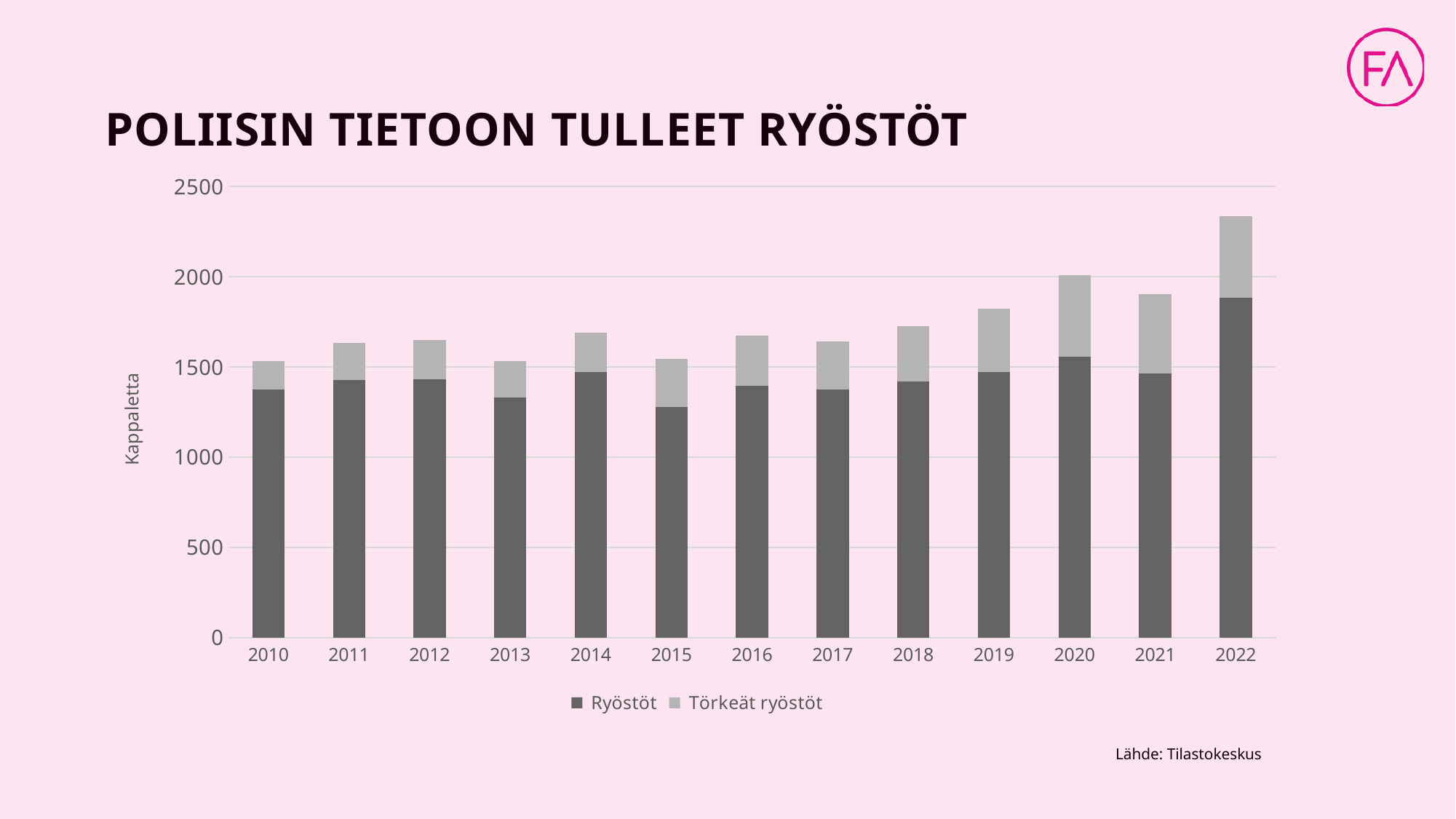
What kind of chart is shown on the slide? Stacked bar chart Does the total number of robberies generally rise or fall from 2010 to 2022? Rise Which year has the lowest value for the Ryöstöt series? 2015 Which year has the highest total number of robberies (tallest stacked bar)? 2022 Is the total stacked bar for 2022 greater or less than 2000? greater Which year has the larger total stacked bar, 2020 or 2022? 2022 How many years are shown on the x axis of the chart? 13 Is the Ryöstöt value for 2015 greater or less than 1500? less Is the Ryöstöt value for 2022 greater or less than 1500? greater What is the label on the chart's y axis? Kappaletta How many series does the chart's legend list? 2